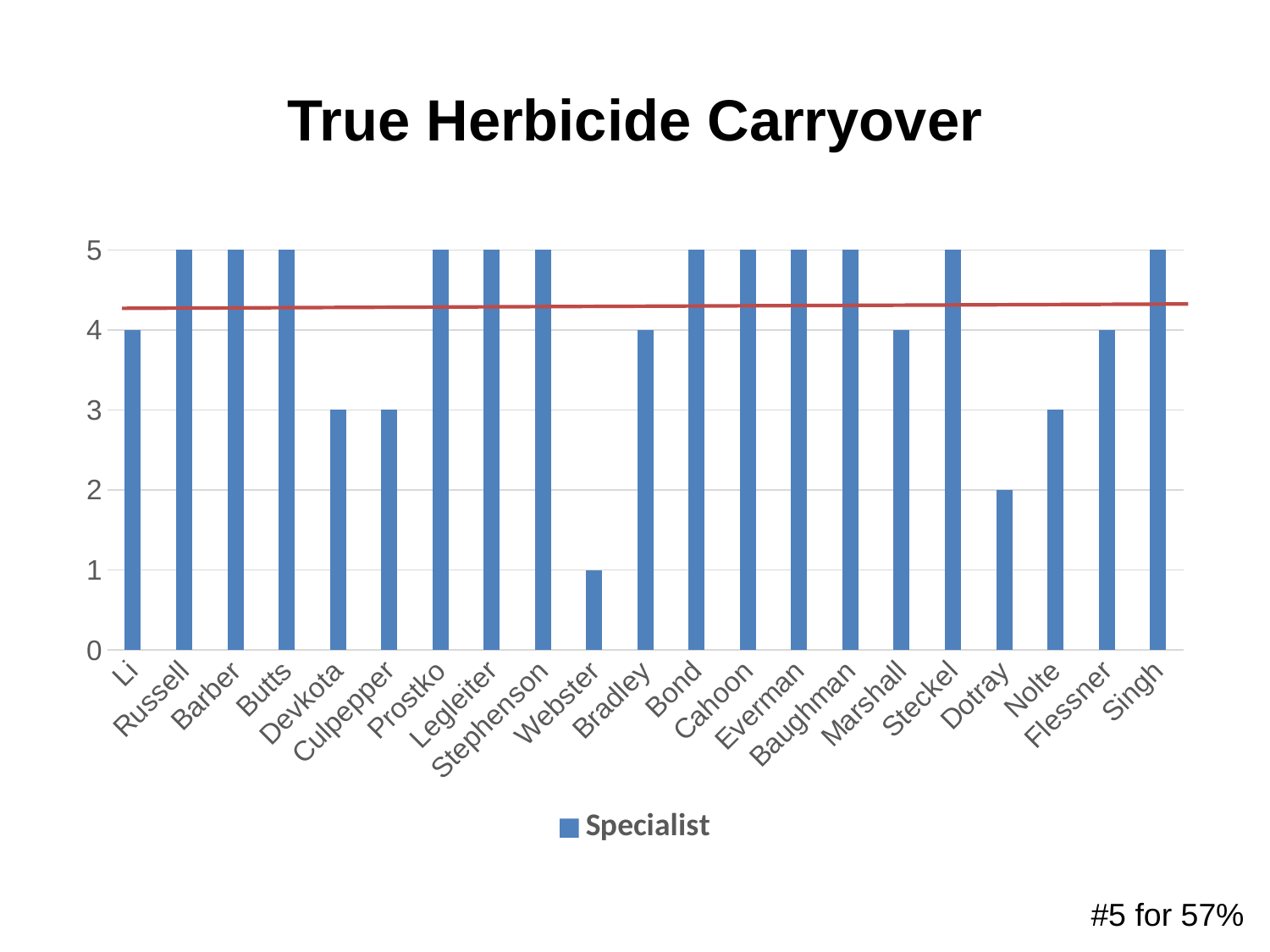
What is the value for Devkota? 3 What is the value for Li? 4 Which is larger, the value for Nolte or the value for Dotray? Nolte How many specialists are shown on the x axis? 21 What is the difference between the values for Li and Webster? 3 Which specialist has the lowest value? Webster What is the value for Webster? 1 What is the difference between the values for Russell and Dotray? 3 How many series does the legend list? 1 What is the value for Dotray? 2 Which is larger, the value for Bradley or the value for Culpepper? Bradley What kind of chart is shown on the slide? Bar chart